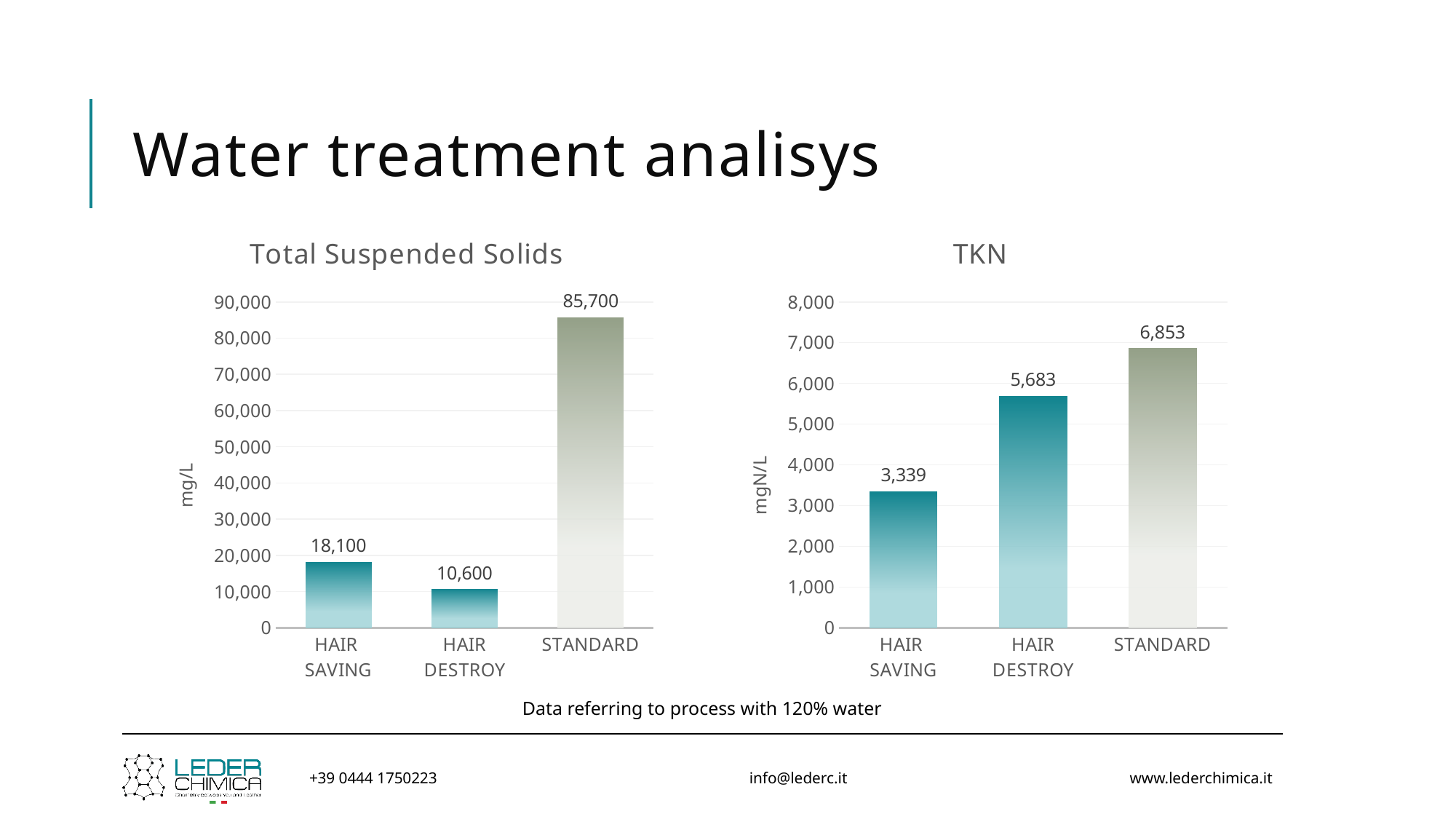
In the TKN chart, what is the difference between STANDARD and HAIR DESTROY? 1,170 In the Total Suspended Solids chart, what is the value for HAIR SAVING? 18,100 In the Total Suspended Solids chart, what is the value for STANDARD? 85,700 What is the y-axis unit label on the TKN chart? mgN/L In the Total Suspended Solids chart, what is the difference between STANDARD and HAIR SAVING? 67,600 What kind of chart is the TKN chart? Bar chart How many categories are shown in the Total Suspended Solids chart? 3 In the TKN chart, which is larger, HAIR SAVING or HAIR DESTROY? HAIR DESTROY In the TKN chart, which category has the highest value? STANDARD In the TKN chart, what is the value for HAIR SAVING? 3,339 In the TKN chart, what is the value for HAIR DESTROY? 5,683 In the Total Suspended Solids chart, which category has the lowest value? HAIR DESTROY